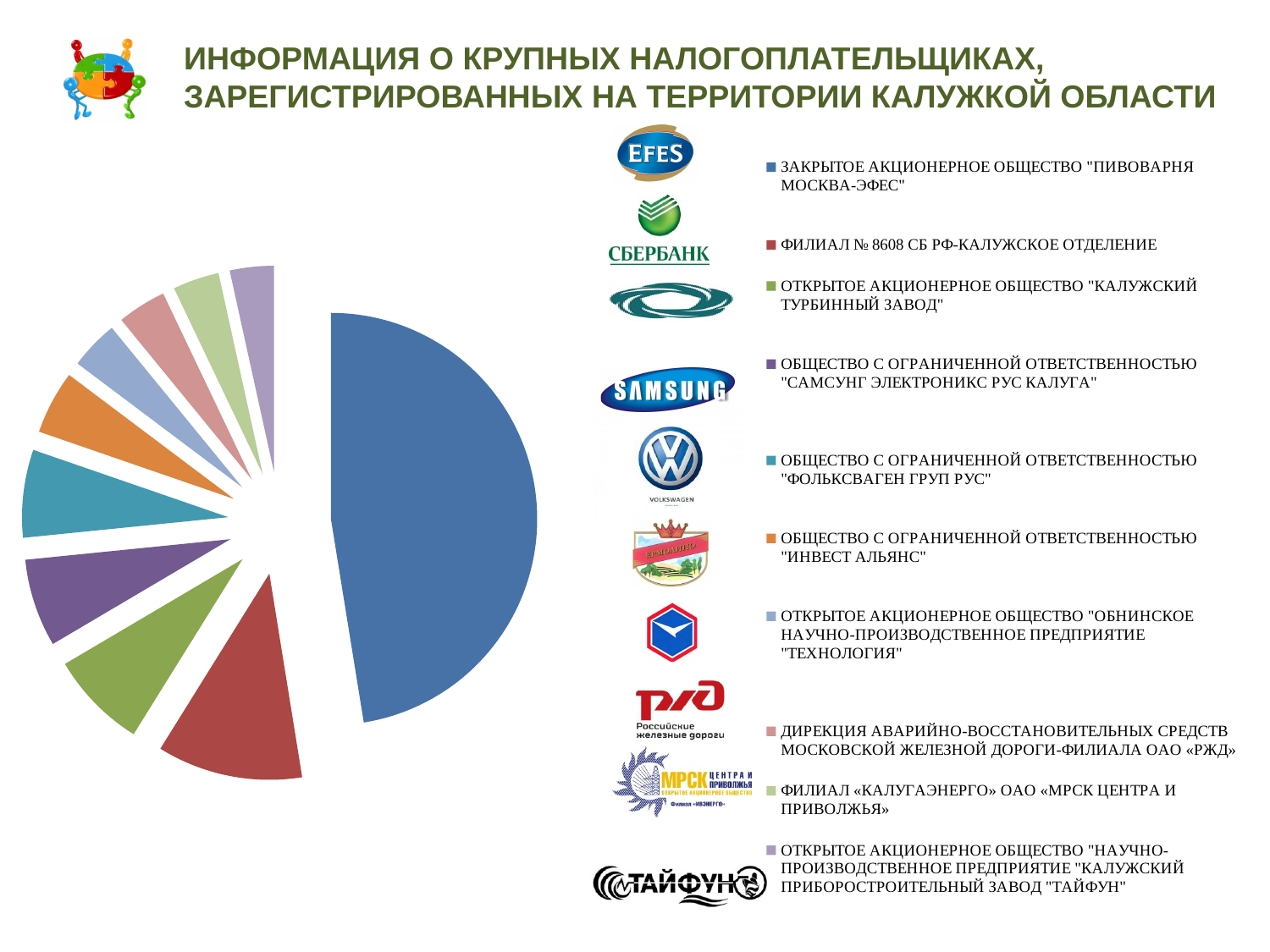
Which slice is larger: ОТКРЫТОЕ АКЦИОНЕРНОЕ ОБЩЕСТВО "КАЛУЖСКИЙ ТУРБИННЫЙ ЗАВОД" or ОТКРЫТОЕ АКЦИОНЕРНОЕ ОБЩЕСТВО "ОБНИНСКОЕ НАУЧНО-ПРОИЗВОДСТВЕННОЕ ПРЕДПРИЯТИЕ "ТЕХНОЛОГИЯ"? ОТКРЫТОЕ АКЦИОНЕРНОЕ ОБЩЕСТВО "КАЛУЖСКИЙ ТУРБИННЫЙ ЗАВОД" Which slice is larger: ЗАКРЫТОЕ АКЦИОНЕРНОЕ ОБЩЕСТВО "ПИВОВАРНЯ МОСКВА-ЭФЕС" or ФИЛИАЛ № 8608 СБ РФ-КАЛУЖСКОЕ ОТДЕЛЕНИЕ? ЗАКРЫТОЕ АКЦИОНЕРНОЕ ОБЩЕСТВО "ПИВОВАРНЯ МОСКВА-ЭФЕС" Which slice is larger: ФИЛИАЛ № 8608 СБ РФ-КАЛУЖСКОЕ ОТДЕЛЕНИЕ or ОТКРЫТОЕ АКЦИОНЕРНОЕ ОБЩЕСТВО "КАЛУЖСКИЙ ТУРБИННЫЙ ЗАВОД"? ФИЛИАЛ № 8608 СБ РФ-КАЛУЖСКОЕ ОТДЕЛЕНИЕ Which legend entry is shown in red? ФИЛИАЛ № 8608 СБ РФ-КАЛУЖСКОЕ ОТДЕЛЕНИЕ How many slices does the pie chart have? 10 Which taxpayer has the largest slice of the pie chart? ЗАКРЫТОЕ АКЦИОНЕРНОЕ ОБЩЕСТВО "ПИВОВАРНЯ МОСКВА-ЭФЕС" How many entries does the legend of the pie chart list? 10 What kind of chart is shown on the slide? pie chart What colour is the largest slice of the pie chart? blue